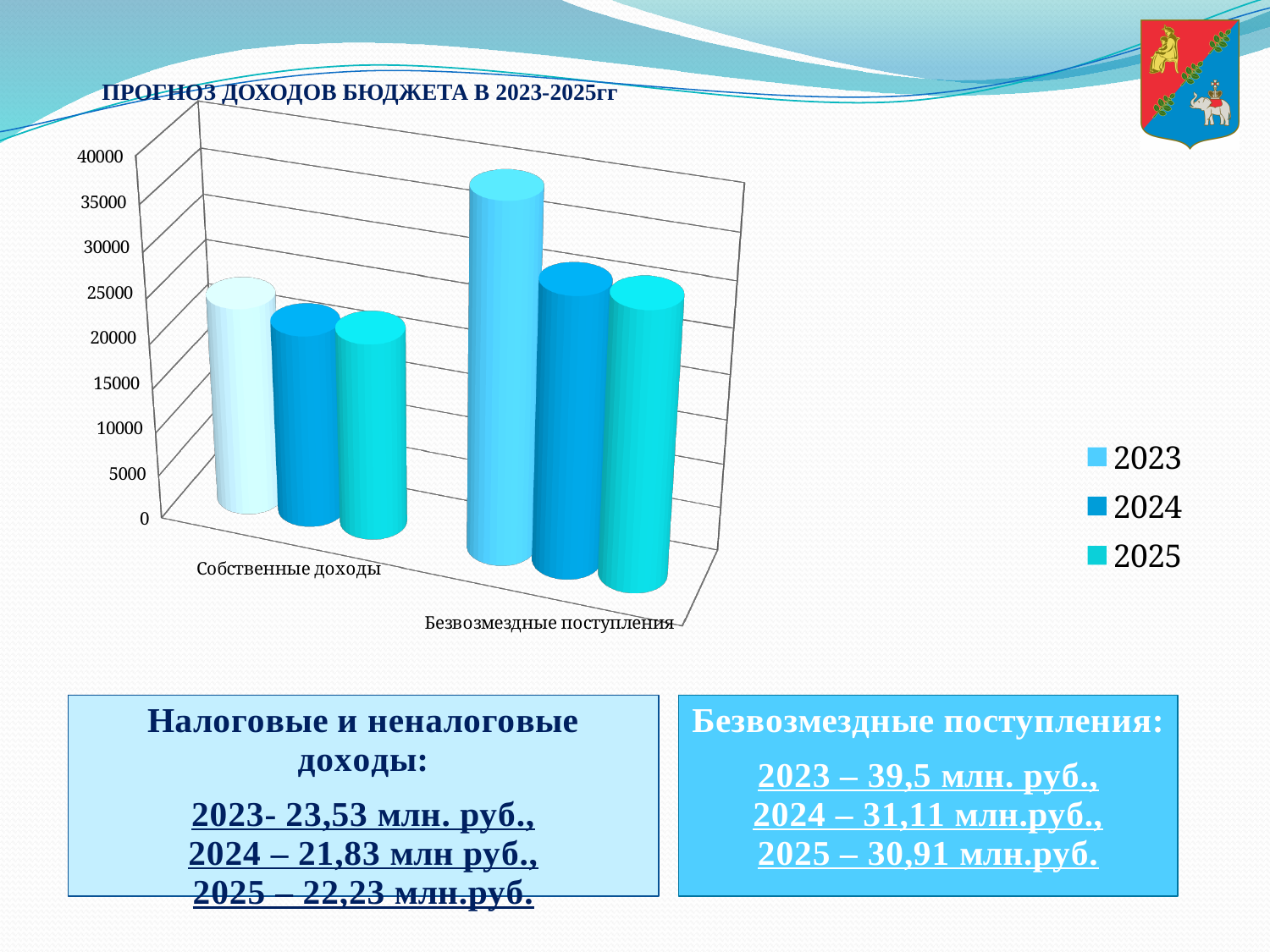
What kind of chart is shown on the slide? bar chart Which entries are listed in the chart legend? 2023, 2024, 2025 Is the value for Безвозмездные поступления in 2023 greater or less than 30000? greater Which year has the highest bar for Собственные доходы? 2023 Which is larger: Собственные доходы in 2023 or Безвозмездные поступления in 2023? Безвозмездные поступления in 2023 Which year has the highest bar for Безвозмездные поступления? 2023 What is the title of the chart? ПРОГНОЗ ДОХОДОВ БЮДЖЕТА В 2023-2025гг Is the value for Безвозмездные поступления in 2024 greater or less than 25000? greater How many series does the chart legend list? 3 Is the value for Собственные доходы in 2023 greater or less than 30000? less Which is larger for Собственные доходы: the 2023 bar or the 2024 bar? 2023 How many categories are shown on the x axis of the chart? 2